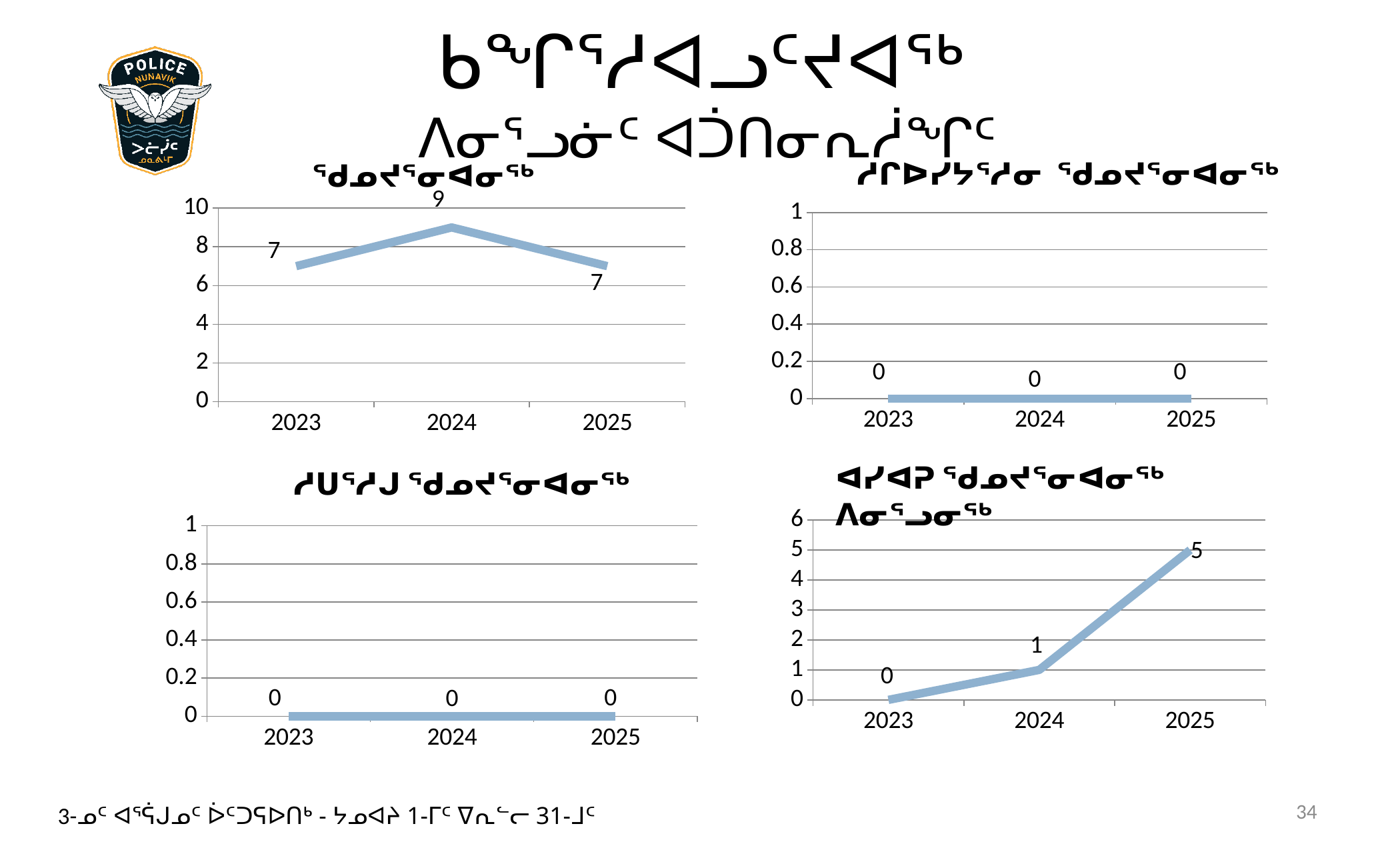
In the bottom-right chart, what is the value for 2024? 1 In the top-right chart, what is the value for 2024? 0 In the bottom-right chart, what is the value for 2025? 5 In the bottom-right chart, which year has the lowest value? 2023 In the top-left chart, what is the value for 2023? 7 What kind of chart is the top-left chart? line chart In the bottom-right chart, what is the difference between the 2025 value and the 2024 value? 4 In the top-left chart, what is the difference between the 2024 value and the 2025 value? 2 In the bottom-right chart, do the values rise or fall from 2023 to 2025? rise How many years are plotted in the bottom-left chart? 3 In the top-left chart, which year has the highest value? 2024 In the top-left chart, what is the value for 2024? 9